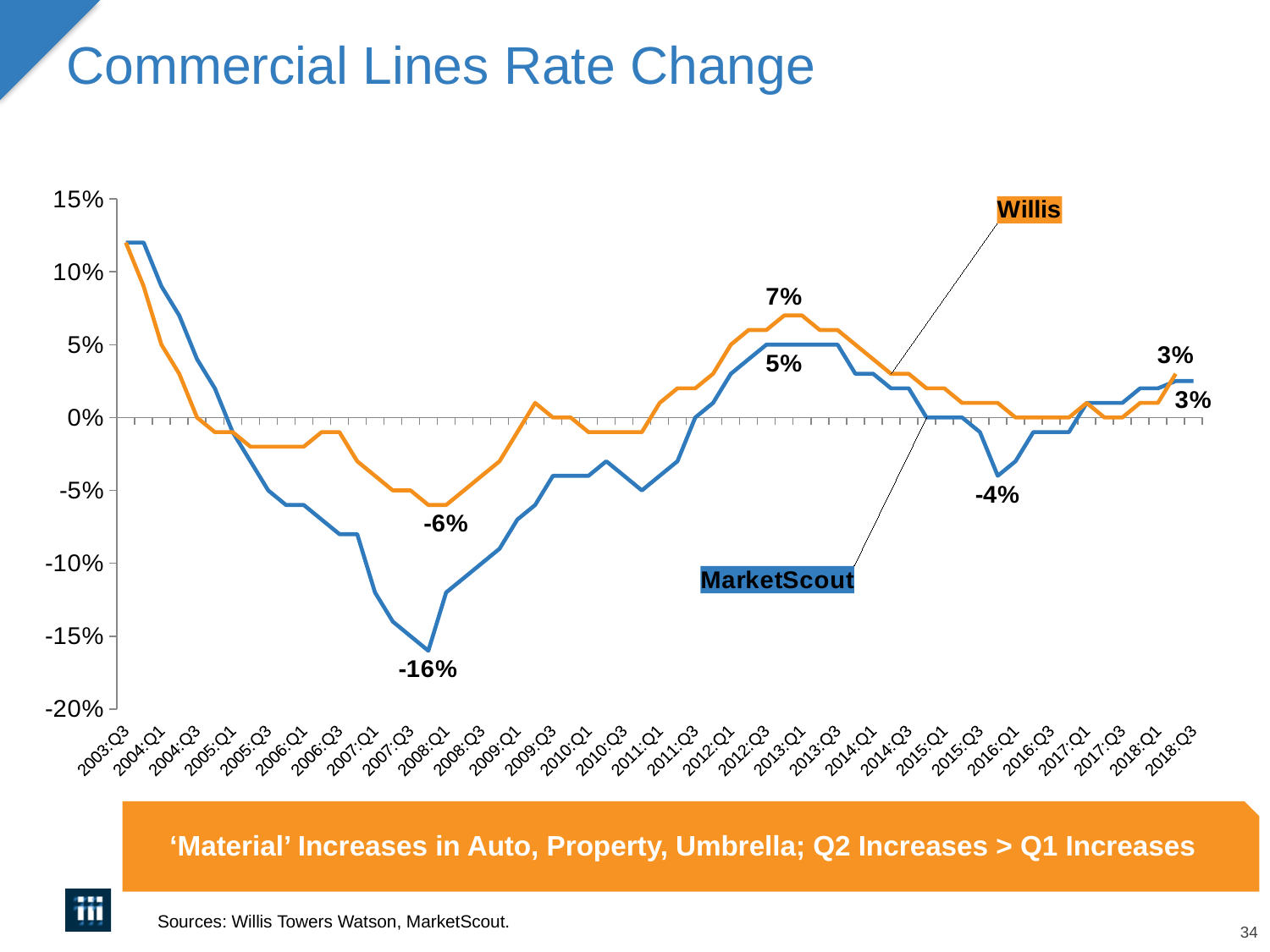
What is the peak value labeled for the Willis series? 7% Is the MarketScout value at 2003:Q3 greater or less than 10%? greater Do the values of both series rise or fall from 2003:Q3 to 2008:Q1? fall What is the peak value labeled for the MarketScout series? 5% What is the lowest value labeled for the Willis series? -6% What kind of chart is shown on the slide? Line chart Which series reached a lower trough, Willis or MarketScout? MarketScout Which colour represents the Willis series in the chart? Orange What is the difference between the labeled peak of Willis (7%) and the labeled peak of MarketScout (5%)? 2 percentage points What value is labeled for the MarketScout series around 2016:Q1? -4% How many series are plotted in the chart? 2 What is the lowest value labeled for the MarketScout series? -16%